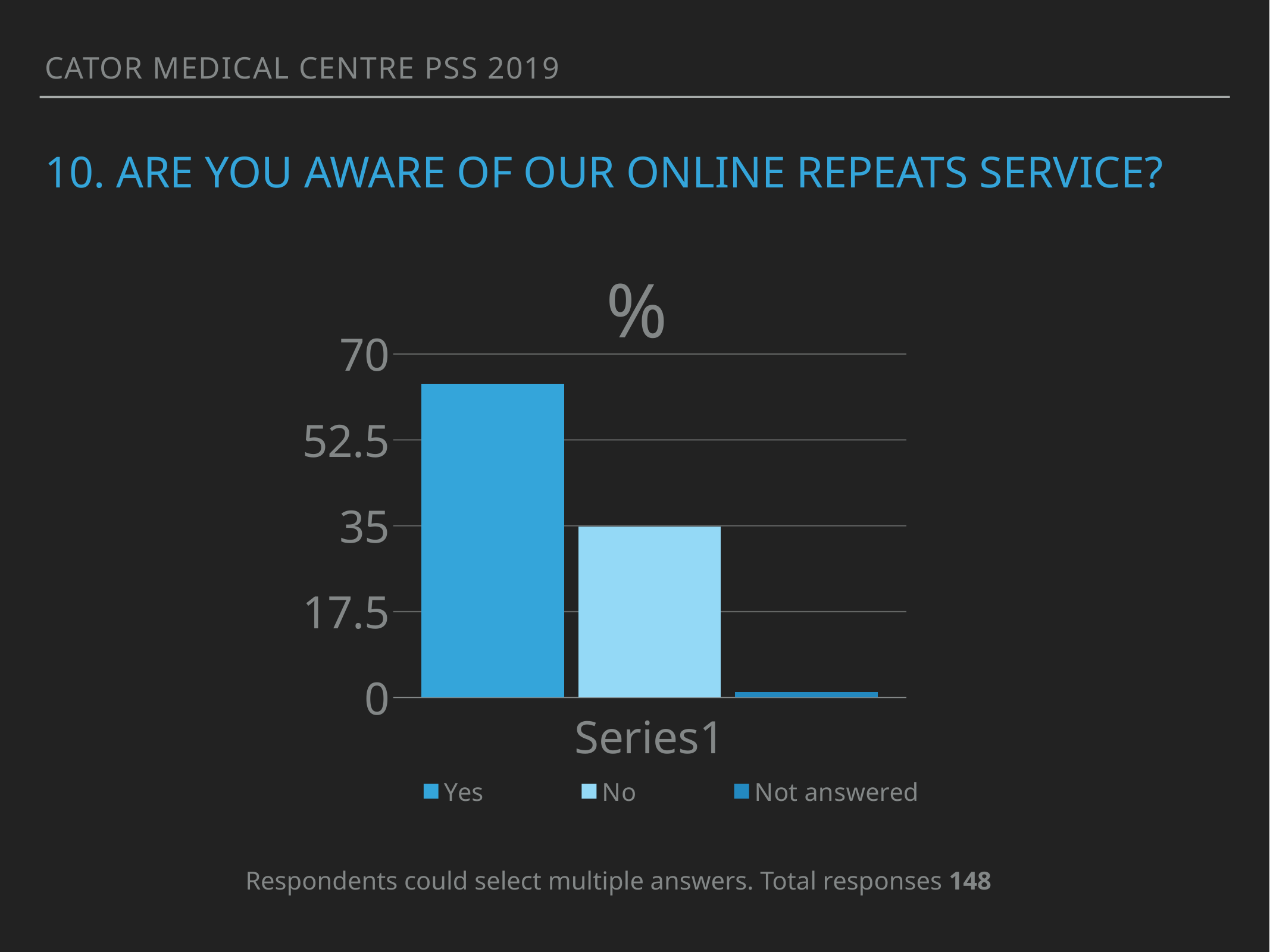
Which series has the highest value in the chart? Yes What are the legend entries of the chart, in order? Yes, No, Not answered How many series does the chart legend list? 3 How many bars are plotted in the chart? 3 What kind of chart is shown on the slide? bar chart Is the value for Yes greater or less than 70? less Which is larger, the value for Yes or the value for No? Yes What is the title of the chart? % Which series has the lowest value in the chart? Not answered Is the value for Not answered greater or less than 17.5? less Is the value for Yes greater or less than 52.5? greater